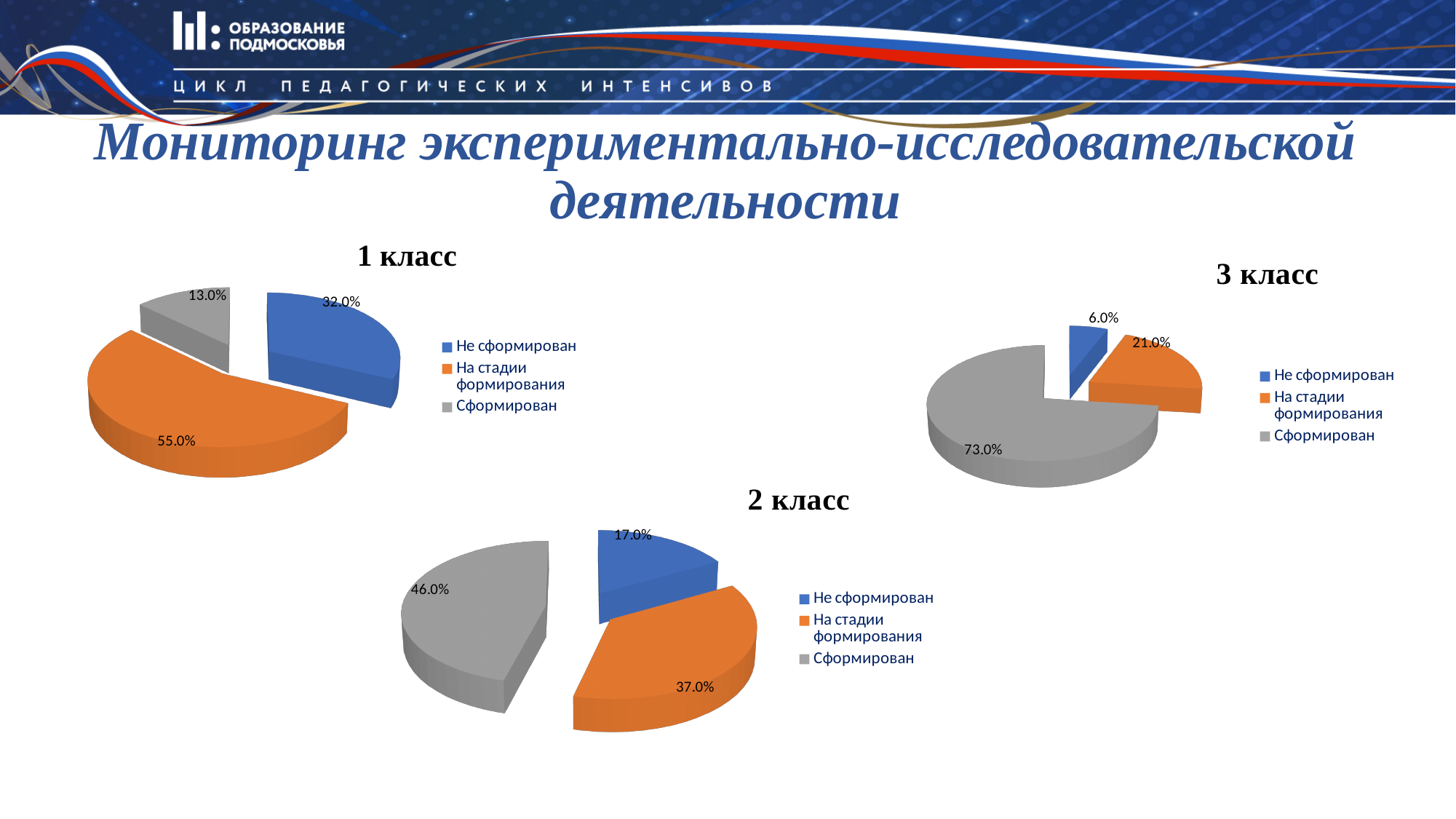
In the '1 класс' pie chart, what is the value for 'Сформирован'? 13.0% In the '3 класс' pie chart, what colour is the 'Сформирован' slice? Grey In the '3 класс' pie chart, what is the value for 'Сформирован'? 73.0% In the '3 класс' pie chart, which is larger: 'На стадии формирования' or 'Не сформирован'? На стадии формирования What type of chart is used for '2 класс'? Pie chart In the '2 класс' pie chart, what is the difference between the 'Сформирован' and 'На стадии формирования' values? 9.0% In the '1 класс' pie chart, what is the value for 'На стадии формирования'? 55.0% In the '2 класс' pie chart, which category has the largest slice? Сформирован How many slices does the '1 класс' pie chart have? 3 In the '3 класс' pie chart, which category has the smallest slice? Не сформирован In the '1 класс' pie chart, which category has the largest slice? На стадии формирования In the '2 класс' pie chart, what is the value for 'Не сформирован'? 17.0%